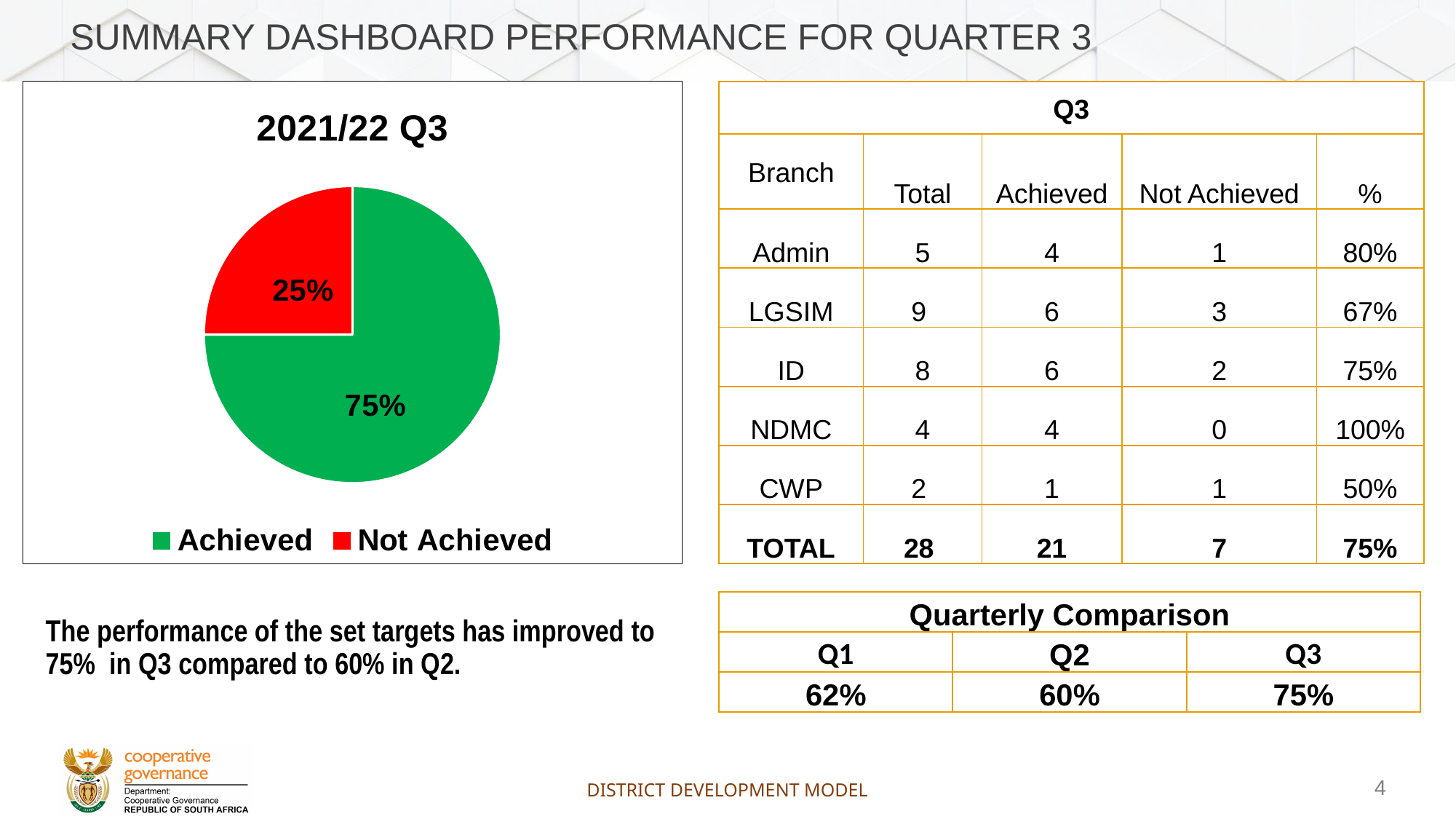
What is the title of the pie chart? 2021/22 Q3 What share of the pie chart is labelled Not Achieved? 25% How many slices does the pie chart have? 2 Is the Achieved share in the pie chart greater or less than 50%? greater Which slice of the pie chart is the largest? Achieved What kind of chart is shown on the slide? pie chart What is the difference in percentage points between the Achieved and Not Achieved slices of the pie chart? 50% What share of the pie chart is labelled Achieved? 75% Which is larger in the pie chart, Achieved or Not Achieved? Achieved What colour is the Not Achieved slice in the pie chart? red Which slice of the pie chart is the smallest? Not Achieved How many entries does the pie chart legend list? 2